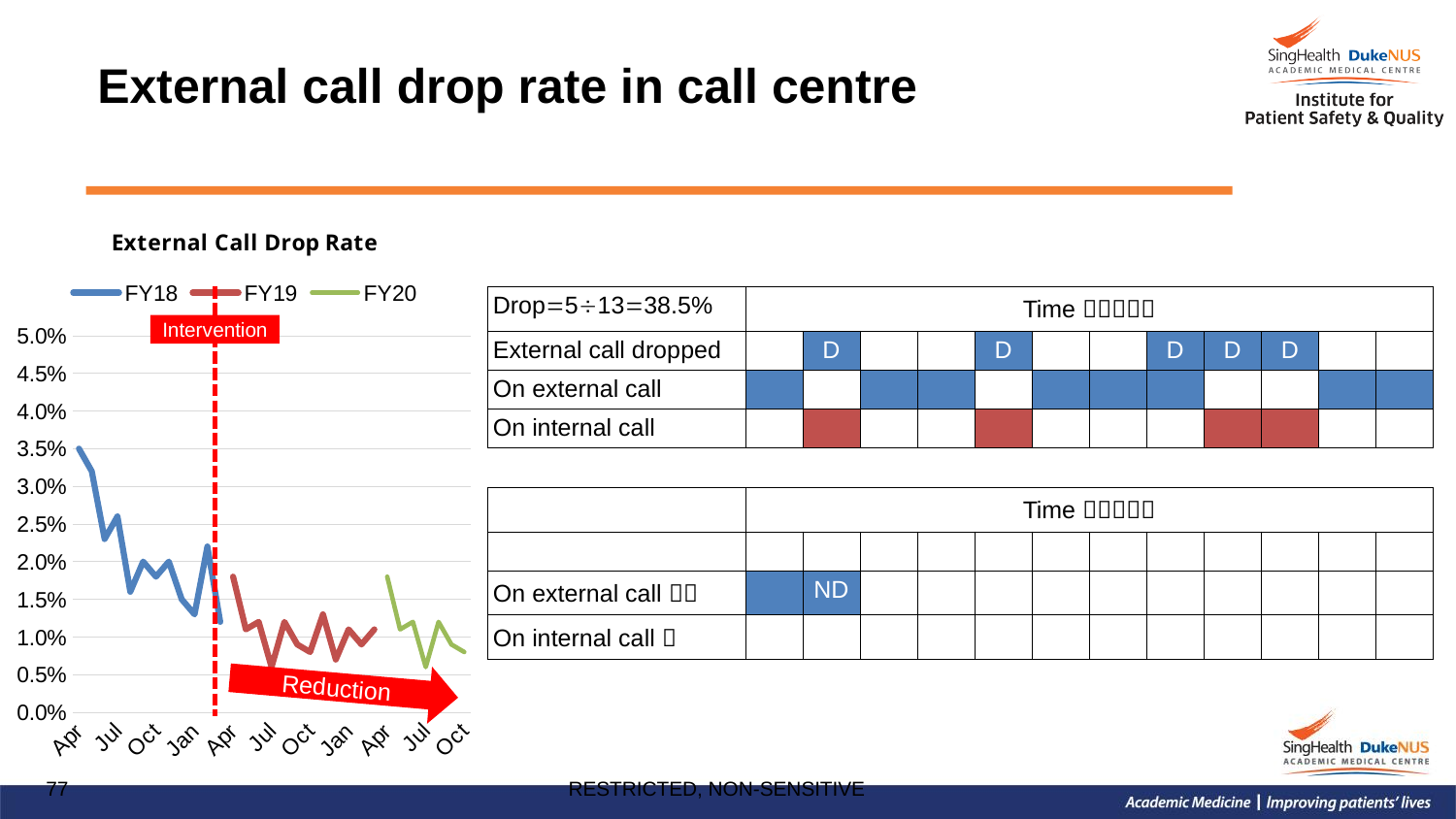
Which is larger in the External Call Drop Rate chart: the first FY18 value or the first FY20 value? the first FY18 value Which series in the External Call Drop Rate chart reaches the highest value? FY18 Is the first FY18 value (Apr) in the External Call Drop Rate chart greater or less than 3.0%? greater What kind of chart is the External Call Drop Rate chart? line chart What is the maximum value shown on the y axis of the External Call Drop Rate chart? 5.0% How many series does the legend of the External Call Drop Rate chart list? 3 What is the title of the line chart on the slide? External Call Drop Rate Which series are listed in the legend of the External Call Drop Rate chart? FY18, FY19, FY20 Does the FY18 line in the External Call Drop Rate chart generally rise or fall from Apr to Jan? fall Is the highest FY19 value in the External Call Drop Rate chart greater or less than 2.5%? less Are the FY20 values in the External Call Drop Rate chart greater or less than 2.0%? less